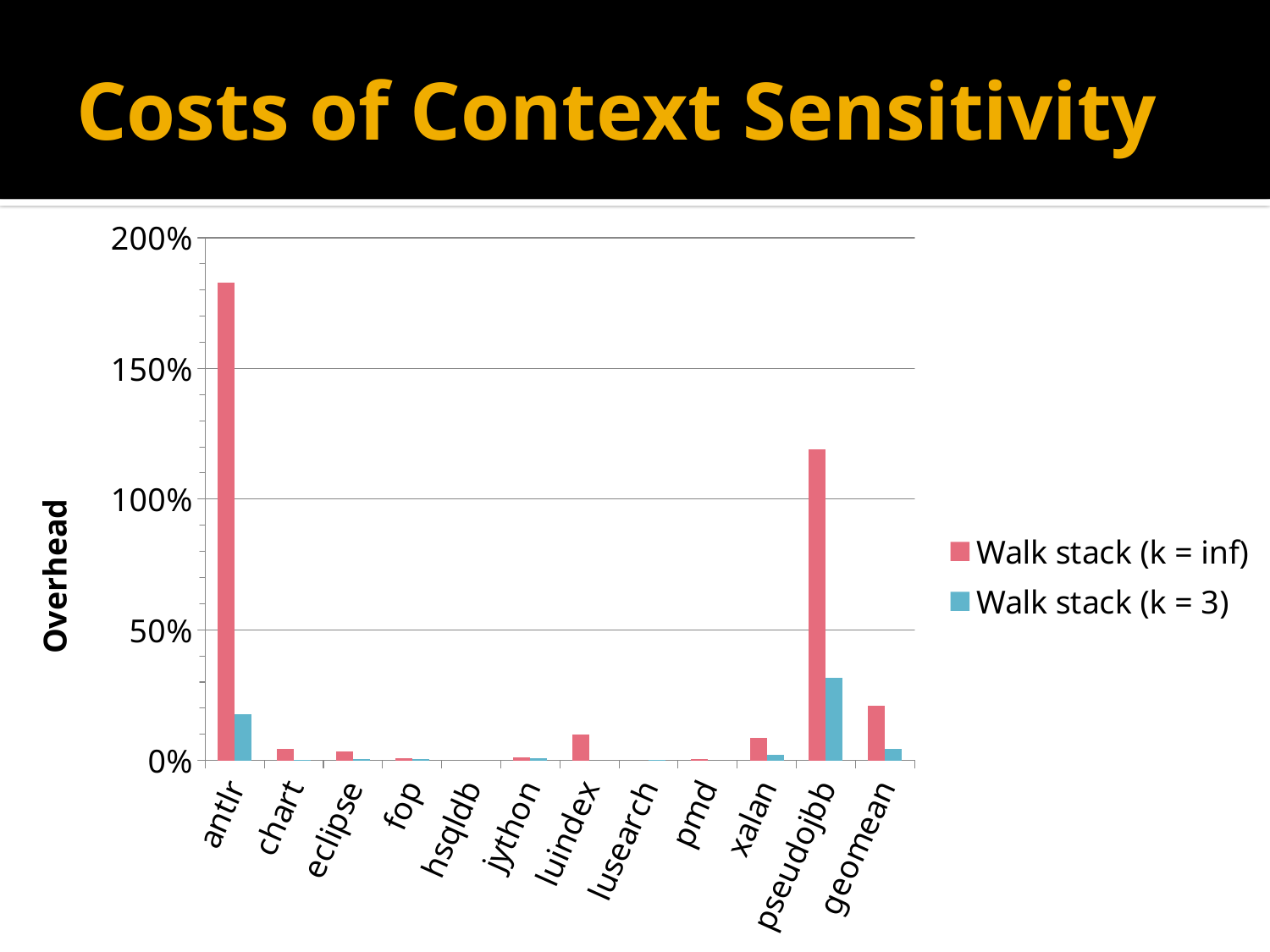
Is the Walk stack (k = 3) value for pseudojbb greater or less than 50%? less Which category has the highest Walk stack (k = 3) overhead? pseudojbb What is the label on the y axis of the chart? Overhead What kind of chart is shown on the slide? Bar chart For the Walk stack (k = inf) series, which is larger: antlr or pseudojbb? antlr Is the Walk stack (k = inf) value for pseudojbb greater or less than 100%? greater For antlr, which series has the larger overhead: Walk stack (k = inf) or Walk stack (k = 3)? Walk stack (k = inf) Is the Walk stack (k = inf) value for antlr greater or less than 150%? greater How many categories are shown along the x axis? 12 How many series does the legend list? 2 Which category has the highest Walk stack (k = inf) overhead? antlr